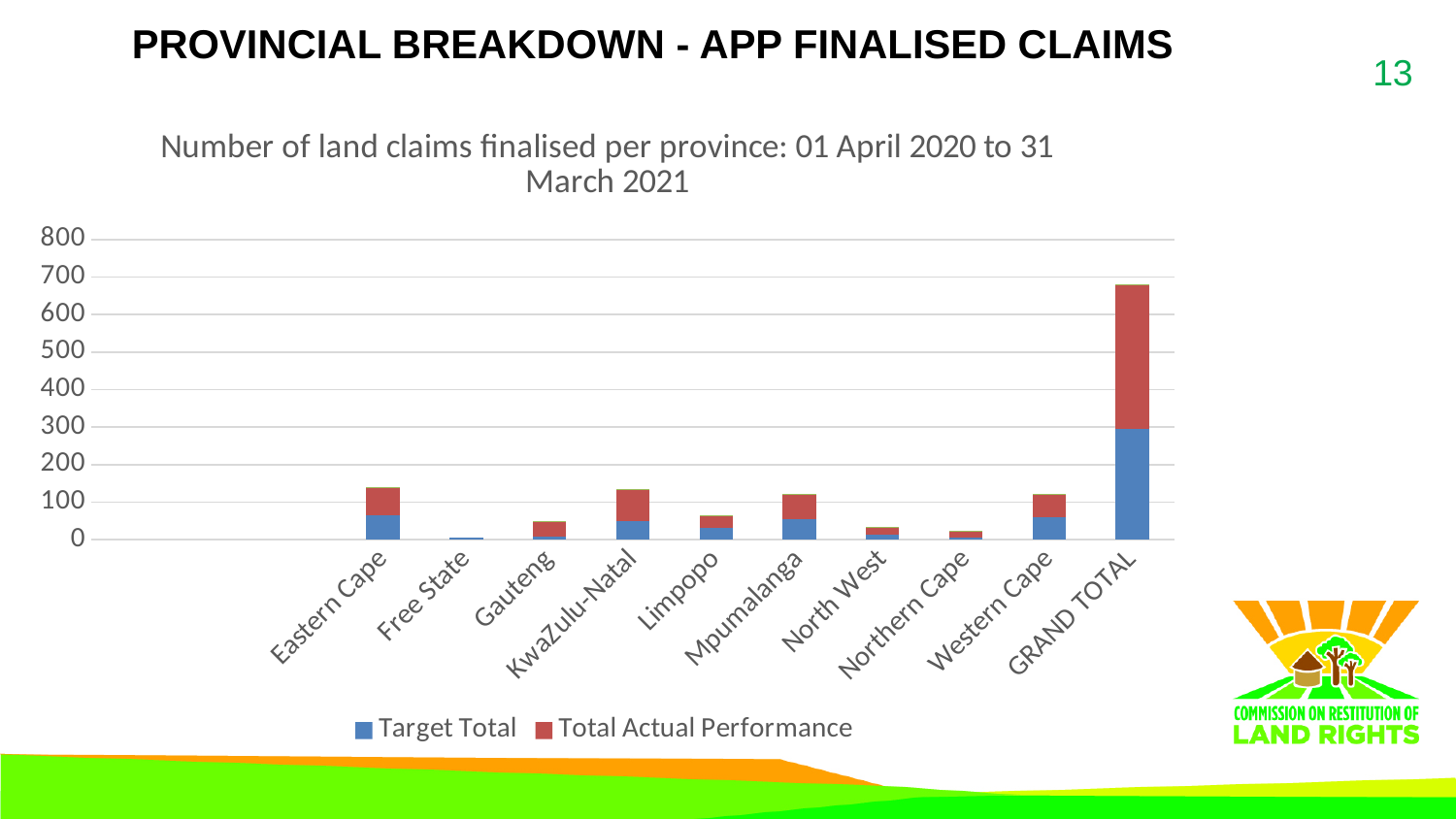
Is the total stacked value for Eastern Cape greater or less than 100? greater Which category has the shortest stacked bar in the chart? Free State Is the total stacked value for Northern Cape greater or less than 100? less Which category has the tallest stacked bar in the chart? GRAND TOTAL Is the total stacked value for GRAND TOTAL greater or less than 600? greater What are the two series named in the chart's legend? Target Total and Total Actual Performance What kind of chart is shown on the slide? Stacked bar chart Which has the taller stacked bar, Western Cape or North West? Western Cape How many categories are shown along the x axis of the chart? 10 How many series does the chart's legend list? 2 Which has the taller stacked bar, Eastern Cape or Gauteng? Eastern Cape